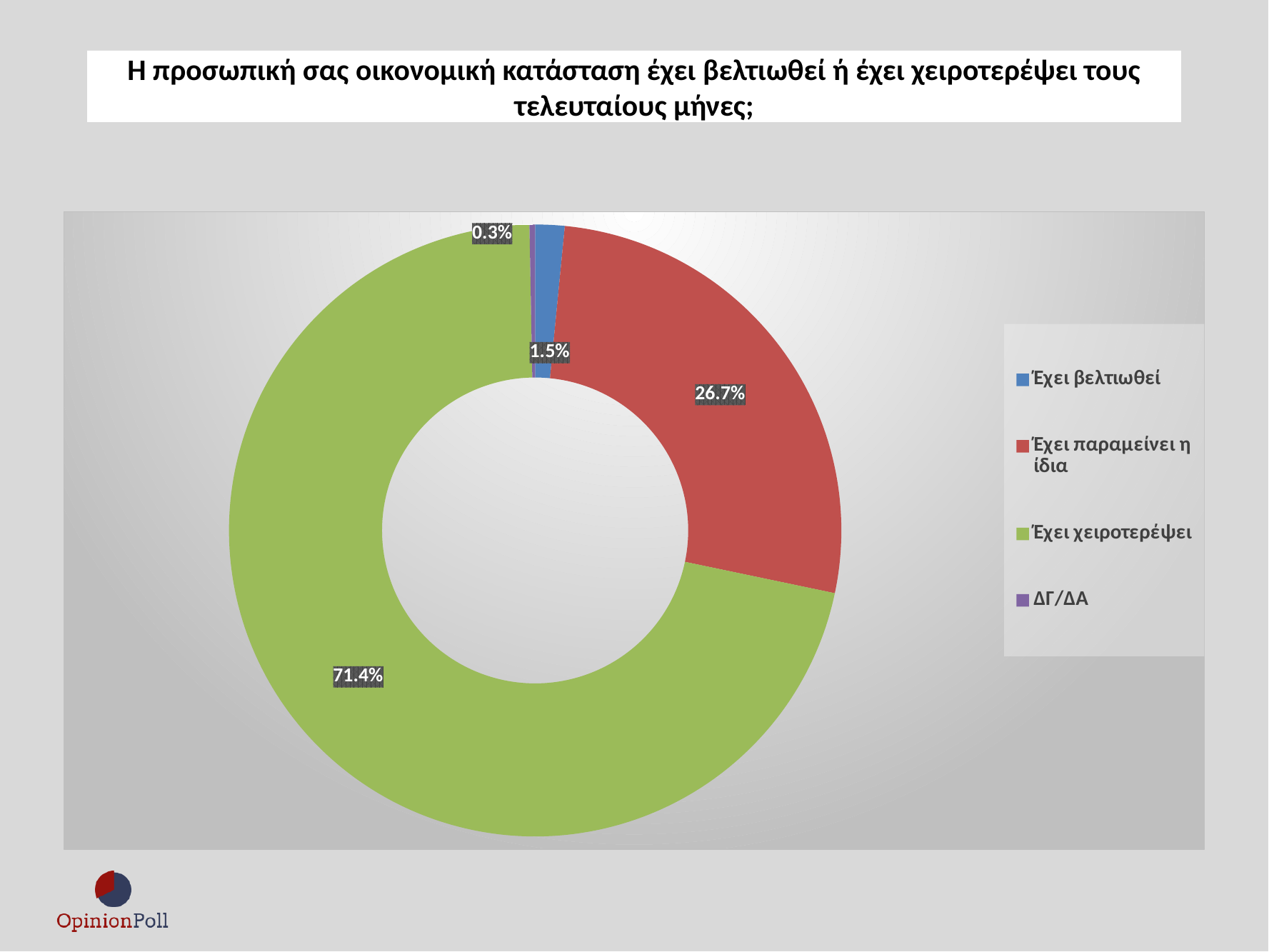
What percentage of respondents answered 'ΔΓ/ΔΑ'? 0.3% What percentage of respondents answered 'Έχει παραμείνει η ίδια'? 26.7% Which is larger, the share for 'Έχει βελτιωθεί' or the share for 'ΔΓ/ΔΑ'? Έχει βελτιωθεί What is the combined share of 'Έχει βελτιωθεί' and 'ΔΓ/ΔΑ'? 1.8% What is the difference in percentage points between 'Έχει χειροτερέψει' and 'Έχει παραμείνει η ίδια'? 44.7 What percentage of respondents answered 'Έχει βελτιωθεί'? 1.5% What colour represents 'Έχει παραμείνει η ίδια' in the chart? Red Which response has the largest share of the chart? Έχει χειροτερέψει Which response has the smallest share of the chart? ΔΓ/ΔΑ What kind of chart is shown on the slide? Pie chart (doughnut) What percentage of respondents answered 'Έχει χειροτερέψει'? 71.4% How many categories are shown in the chart? 4